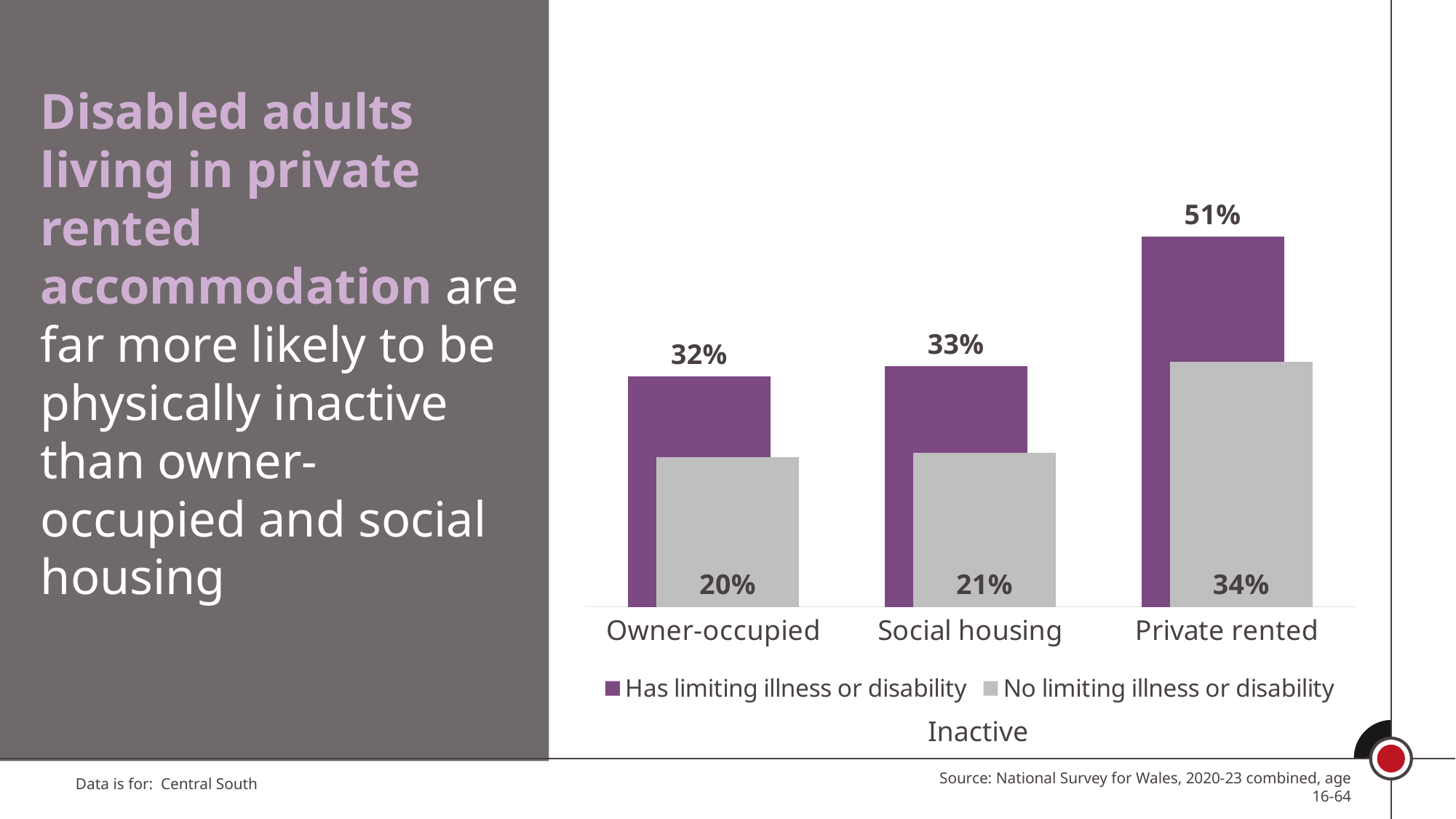
What is the value for Owner-occupied in the 'No limiting illness or disability' series? 20% What is the value for Private rented in the 'Has limiting illness or disability' series? 51% What is the value for Private rented in the 'No limiting illness or disability' series? 34% What is the difference between the 'Has limiting illness or disability' and 'No limiting illness or disability' values for Private rented? 17% Which housing category has the lowest value for 'No limiting illness or disability'? Owner-occupied What kind of chart is shown on the slide? Bar chart What is the difference between the 'Has limiting illness or disability' values for Private rented and Owner-occupied? 19% How many housing categories are shown on the x axis? 3 How many series does the legend list? 2 Which housing category has the highest value for 'Has limiting illness or disability'? Private rented Which is larger: the 'Has limiting illness or disability' value for Owner-occupied or the 'No limiting illness or disability' value for Private rented? No limiting illness or disability value for Private rented What is the value for Social housing in the 'Has limiting illness or disability' series? 33%